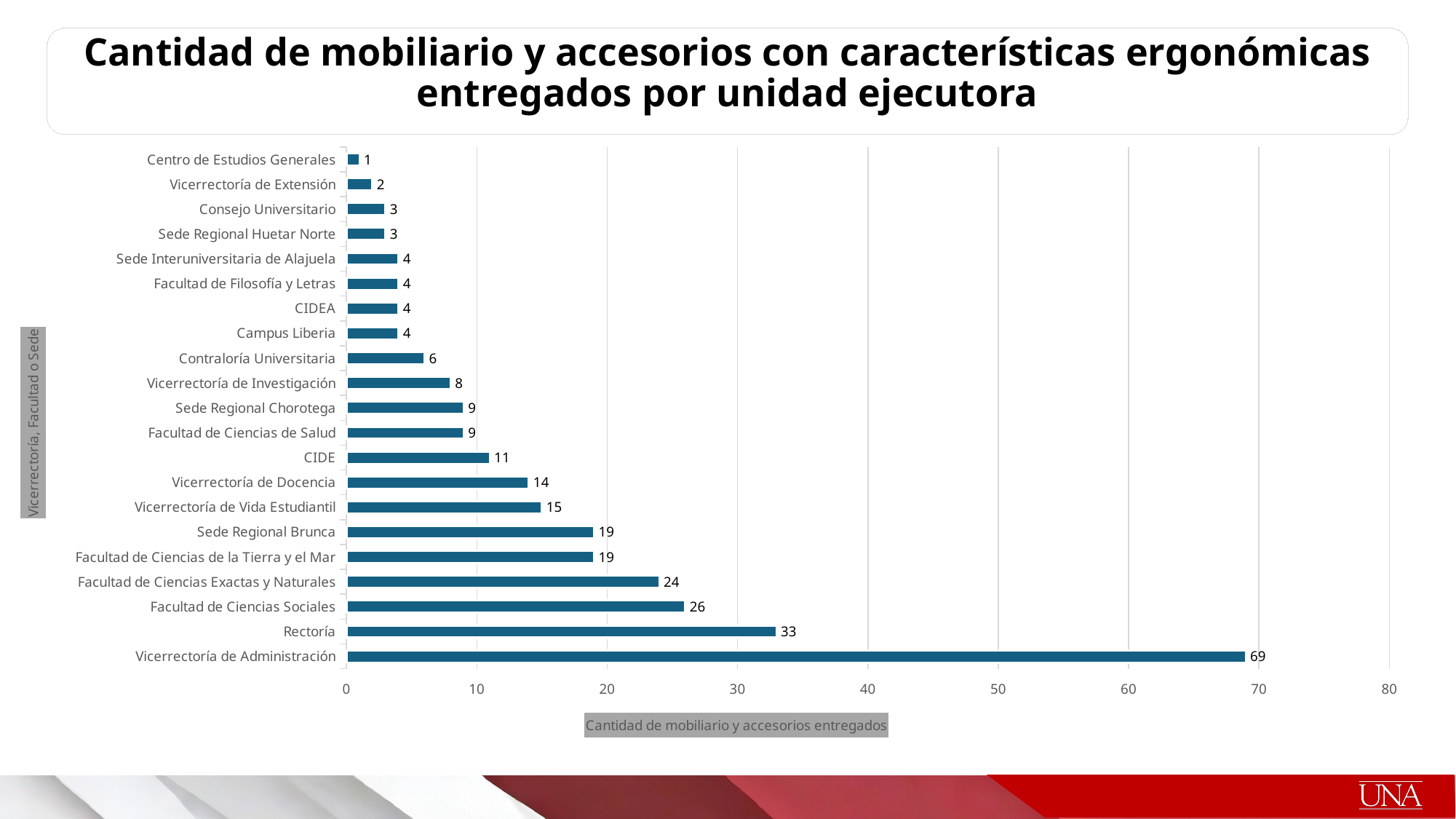
Is the value for Facultad de Ciencias Exactas y Naturales greater or less than 20? greater Which is larger, the value for CIDE or the value for Contraloría Universitaria? CIDE How many categories are shown in the chart? 21 What is the value for Rectoría? 33 What is the difference between the values for Vicerrectoría de Administración and Rectoría? 36 What is the label of the horizontal axis? Cantidad de mobiliario y accesorios entregados Which category has the highest value? Vicerrectoría de Administración What is the title of the chart? Cantidad de mobiliario y accesorios con características ergonómicas entregados por unidad ejecutora What is the value for Vicerrectoría de Docencia? 14 What kind of chart is shown on the slide? bar chart What is the value for Facultad de Ciencias Sociales? 26 Which category has the lowest value? Centro de Estudios Generales